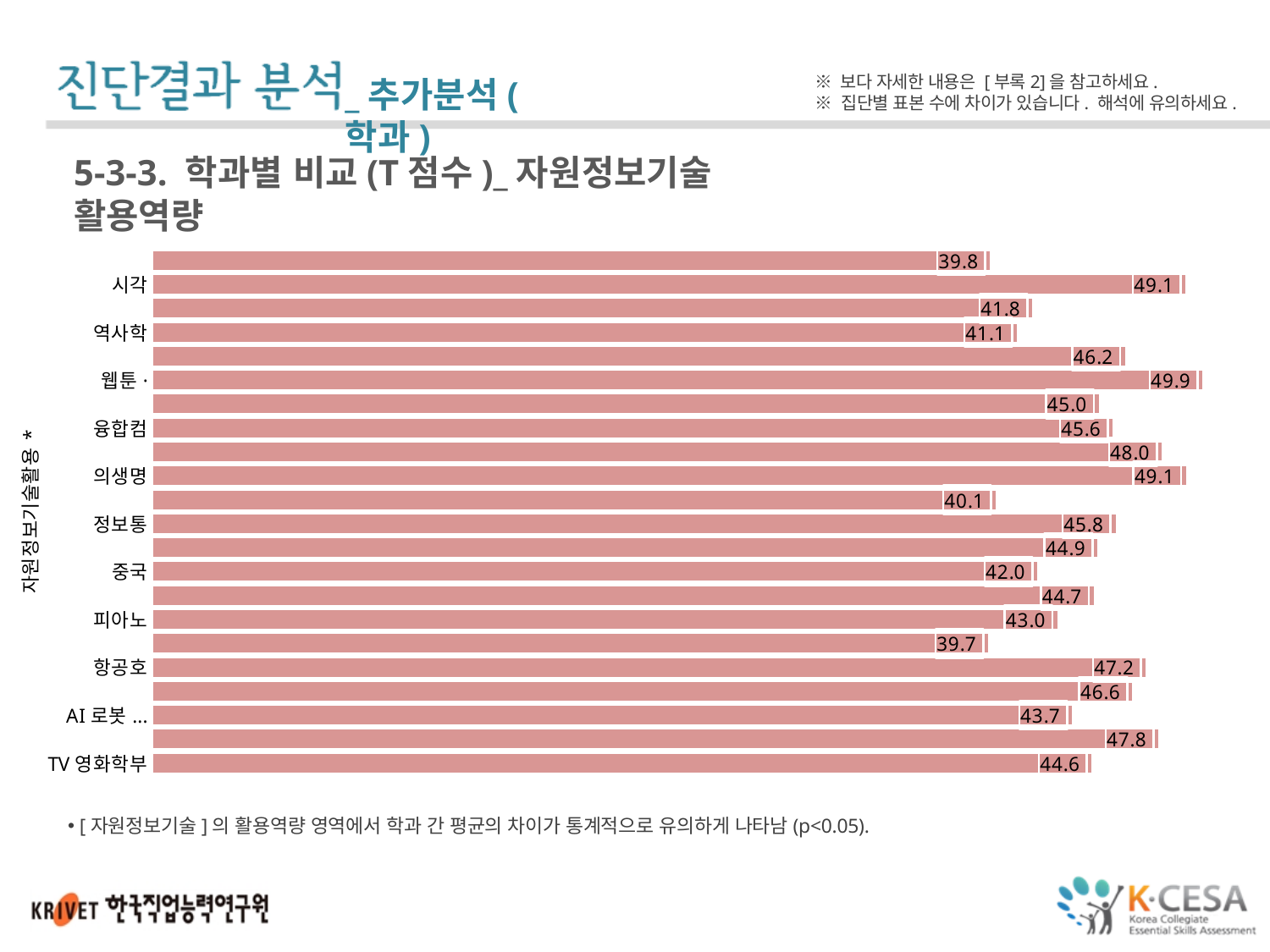
What is the value for 웹툰·? 49.9 Which labeled category has the highest value? 웹툰· What is the value for 중국? 42.0 What is the value for TV 영화학부? 44.6 How many bars are plotted in the chart? 22 What is the difference between the values for 웹툰· and 역사학? 8.8 Which labeled category has the lowest value? 역사학 Which is larger, the value for 항공호 or the value for 피아노? 항공호 What is the value for 역사학? 41.1 What kind of chart is shown on the slide? bar chart What is the value for AI 로봇 ...? 43.7 What is the value for 시각? 49.1